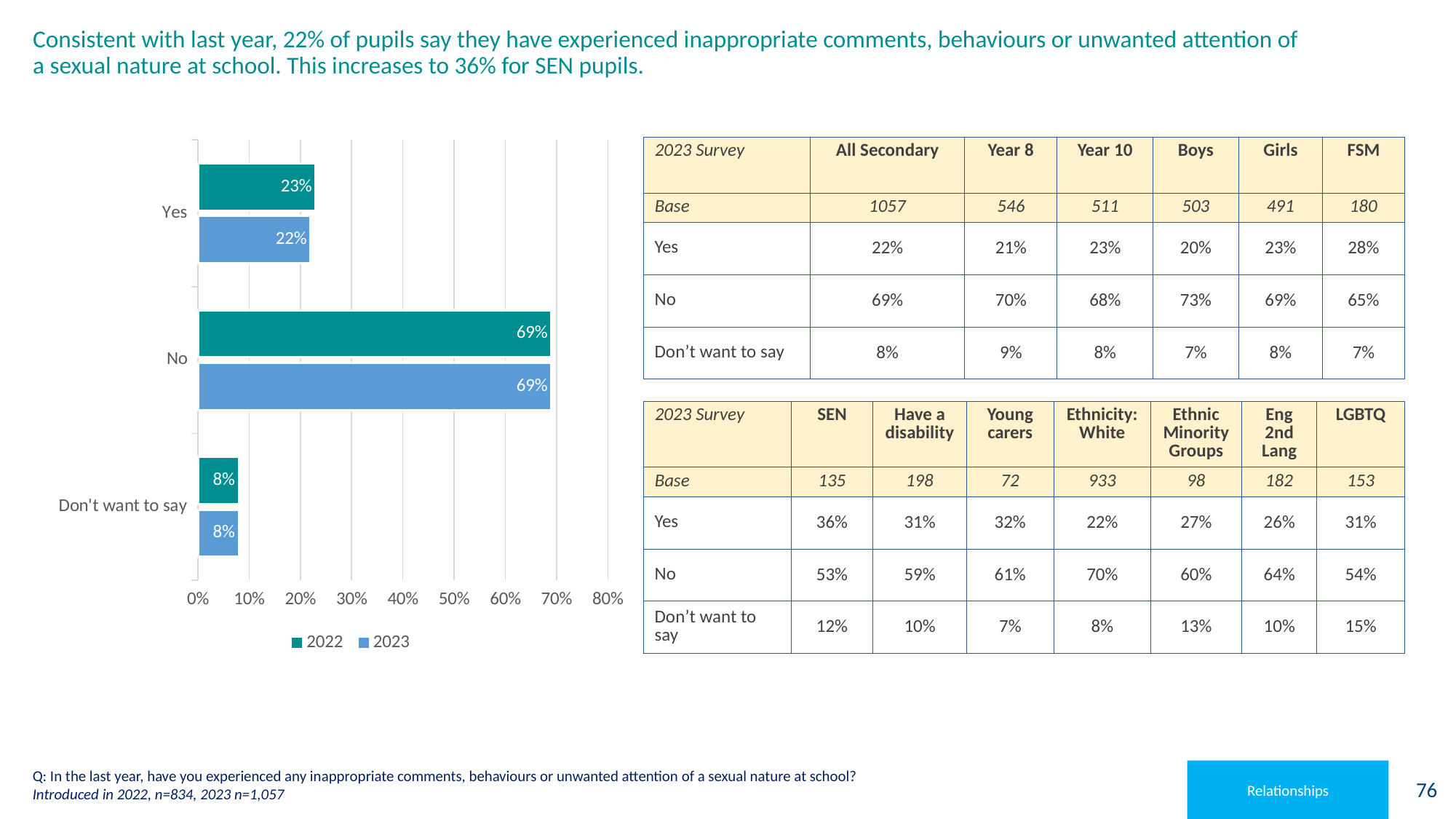
What is the 2022 value for 'Don't want to say' in the chart? 8% How many series does the chart legend list? 2 Which series is shown in the darker teal colour in the chart? 2022 What is the 2023 value for 'Yes' in the chart? 22% Which category has the lowest value for the 2022 series? Don't want to say What is the 2022 value for 'Yes' in the chart? 23% What is the 2023 value for 'No' in the chart? 69% What kind of chart is shown on the slide? bar chart What is the difference between the 2022 and 2023 values for 'Yes'? 1% Which category has the highest value for the 2023 series? No How many categories are shown on the chart? 3 Is the 2023 value for 'No' greater or less than 60%? greater